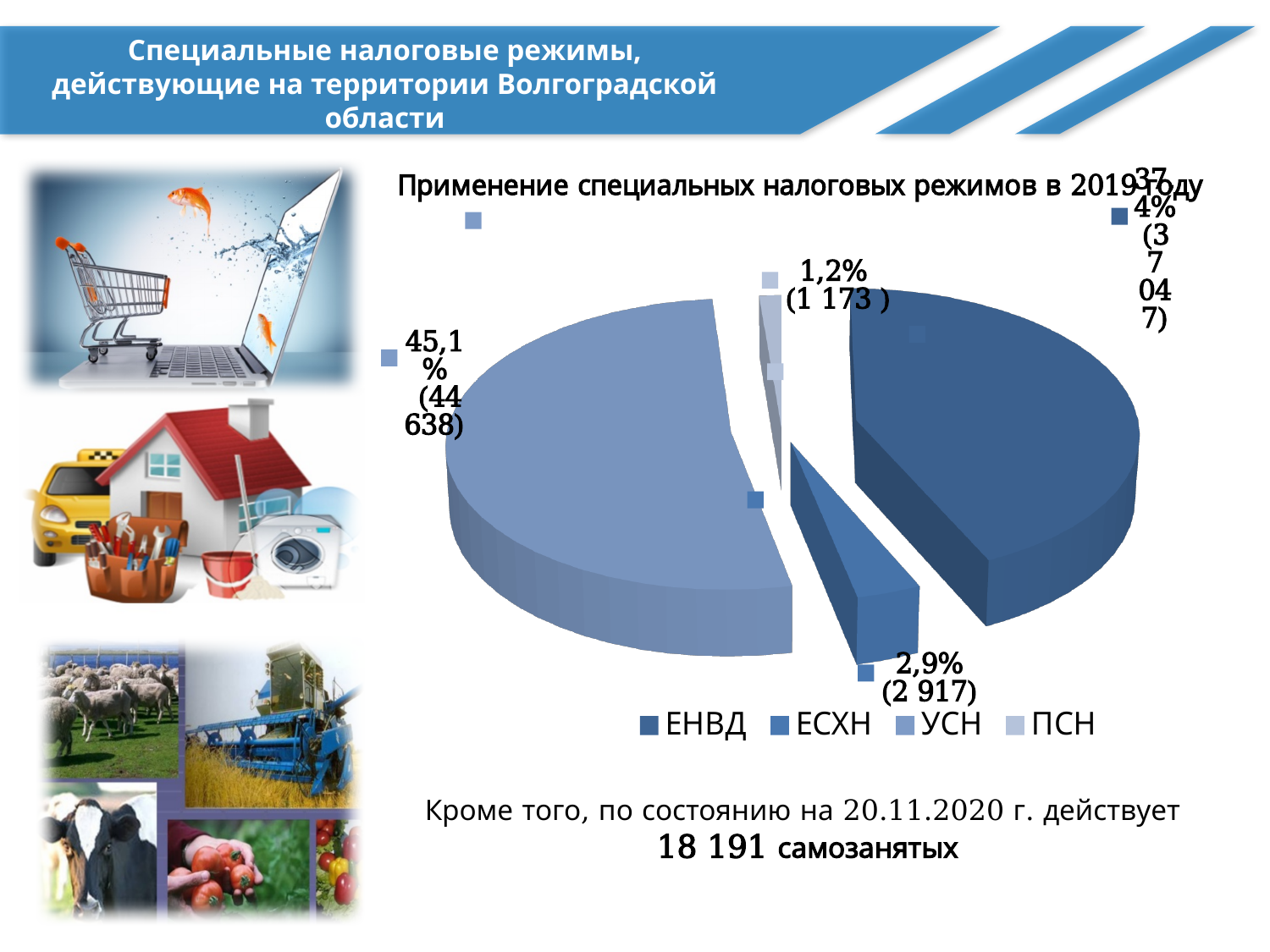
What is the difference in percentage points between the УСН share and the ЕСХН share? 42,2% Which tax regime has the smallest slice of the pie? ПСН What percentage share does УСН have in the pie chart? 45,1% What percentage share does ЕСХН have in the pie chart? 2,9% What number is shown in parentheses for ПСН? 1 173 What kind of chart is shown on the slide? pie chart What percentage share does ЕНВД have in the pie chart? 37,4% Which has the larger share, ЕНВД or ЕСХН? ЕНВД What is the title of the chart? Применение специальных налоговых режимов в 2019 году Which tax regime has the largest slice of the pie? УСН What number is shown in parentheses for УСН? 44 638 How many entries does the chart legend list? 4